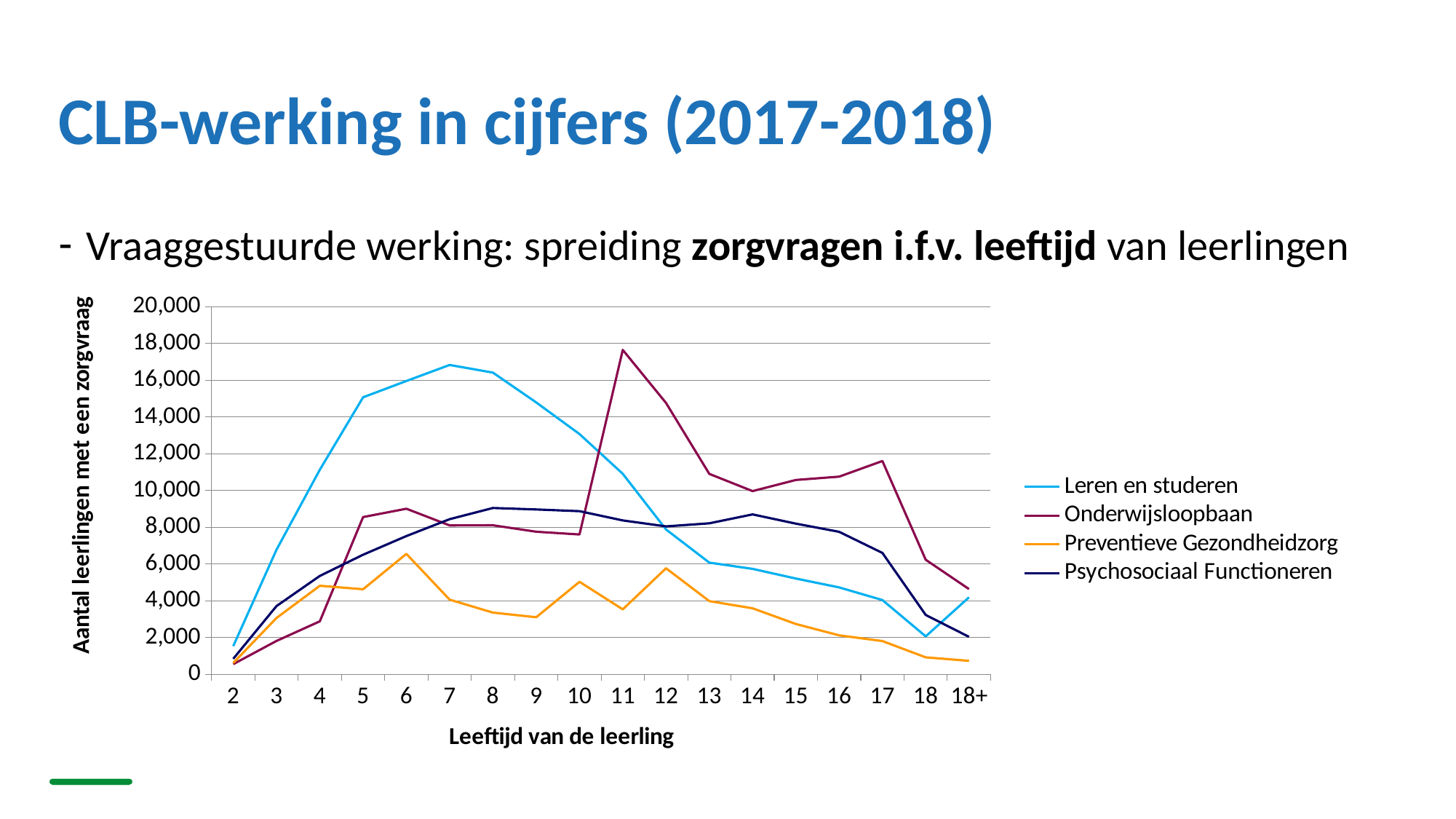
What is the title of the x axis? Leeftijd van de leerling Is the value for Preventieve Gezondheidzorg at age 18+ greater or less than 2,000? less At which age does the Onderwijsloopbaan line reach its highest value? 11 What kind of chart is shown on the slide? line chart How many series does the legend list? 4 Is the value for Leren en studeren at age 7 greater or less than 16,000? greater At age 12, which series has the larger value, Leren en studeren or Onderwijsloopbaan? Onderwijsloopbaan Does the Leren en studeren line rise or fall from age 7 to age 18? fall At age 5, which series has the larger value, Leren en studeren or Psychosociaal Functioneren? Leren en studeren At which age does the Leren en studeren line reach its highest value? 7 How many age categories are shown on the x axis? 18 Which series has the lowest value at age 17? Preventieve Gezondheidzorg